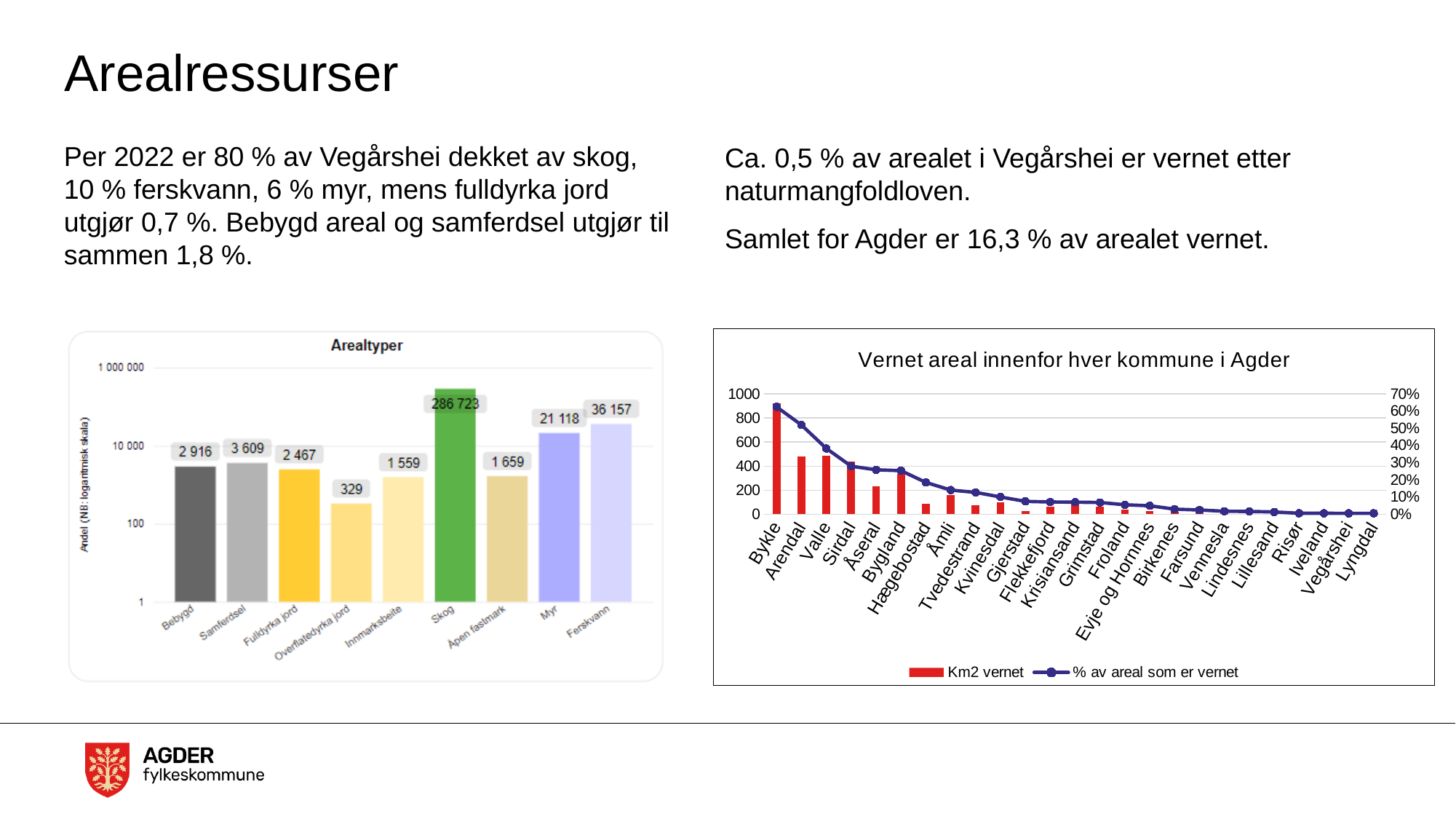
How many series does the legend of the chart 'Vernet areal innenfor hver kommune i Agder' list? 2 In the Arealtyper chart, what is the value for Skog? 286 723 In the Arealtyper chart, which category has the highest value? Skog In the Arealtyper chart, what is the value for Myr? 21 118 In the chart 'Vernet areal innenfor hver kommune i Agder', which municipality has the highest Km2 vernet? Bykle In the Arealtyper chart, which is larger, Bebygd or Samferdsel? Samferdsel In the chart 'Vernet areal innenfor hver kommune i Agder', does the '% av areal som er vernet' line rise or fall from left to right? fall In the chart 'Vernet areal innenfor hver kommune i Agder', is the Km2 vernet value for Bykle greater or less than 800? greater In the Arealtyper chart, what is the difference between the values for Ferskvann and Myr? 15 039 In the Arealtyper chart, which category has the lowest value? Overflatedyrka jord How many municipalities are shown on the x axis of the chart 'Vernet areal innenfor hver kommune i Agder'? 25 How many categories are shown in the Arealtyper chart? 9